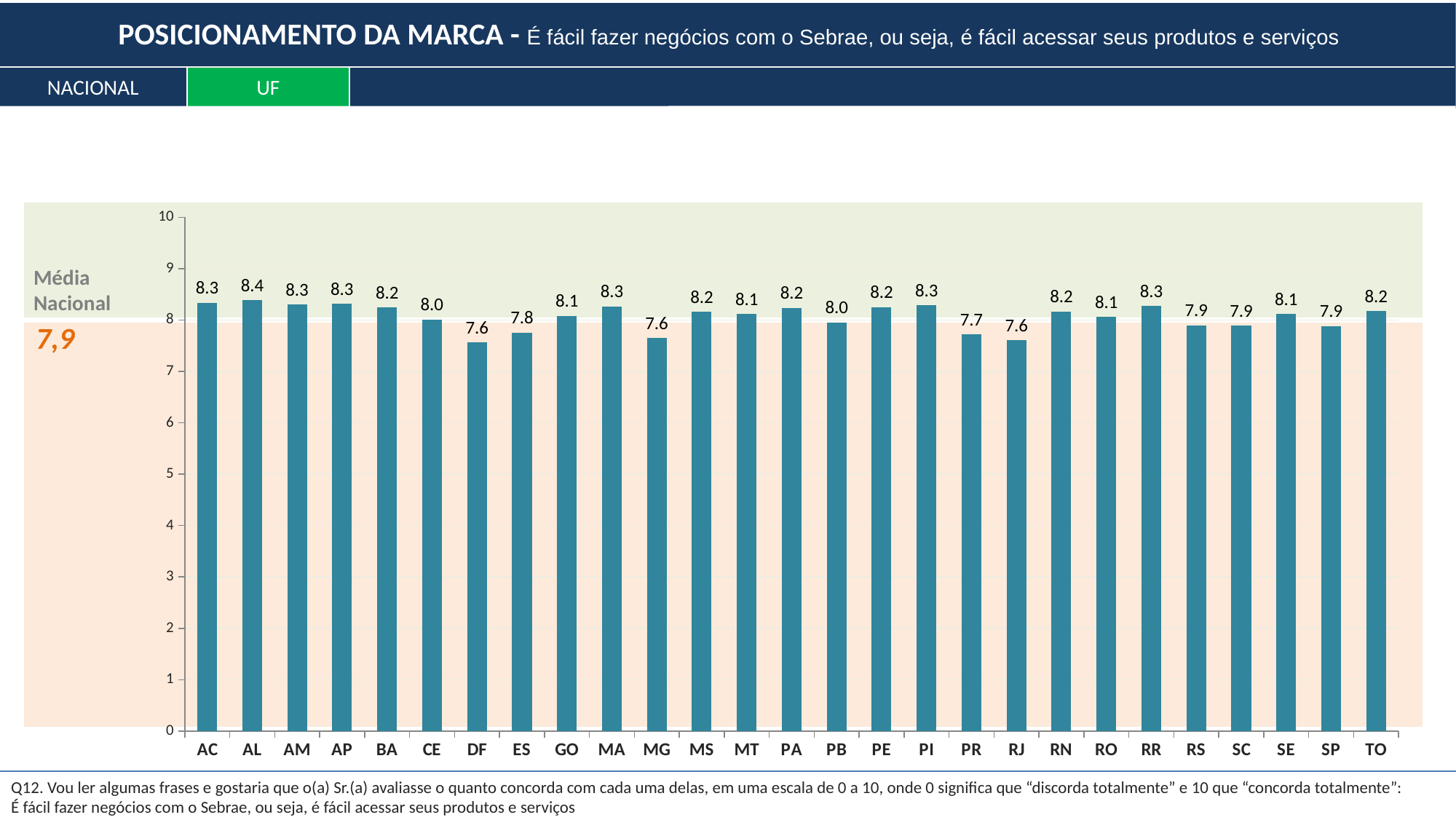
What is the Média Nacional value shown on the chart? 7,9 Is the value for PR greater or less than 8? less What is the value for DF? 7.6 Which has a larger value, CE or ES? CE What is the value for SP? 7.9 How many states are shown on the x axis? 27 What is the value for PE? 8.2 What is the value for AL? 8.4 Which state has the highest value? AL What is the difference between the values for MA and MG? 0.7 What kind of chart is shown? bar chart What is the difference between the values for AL and RJ? 0.8